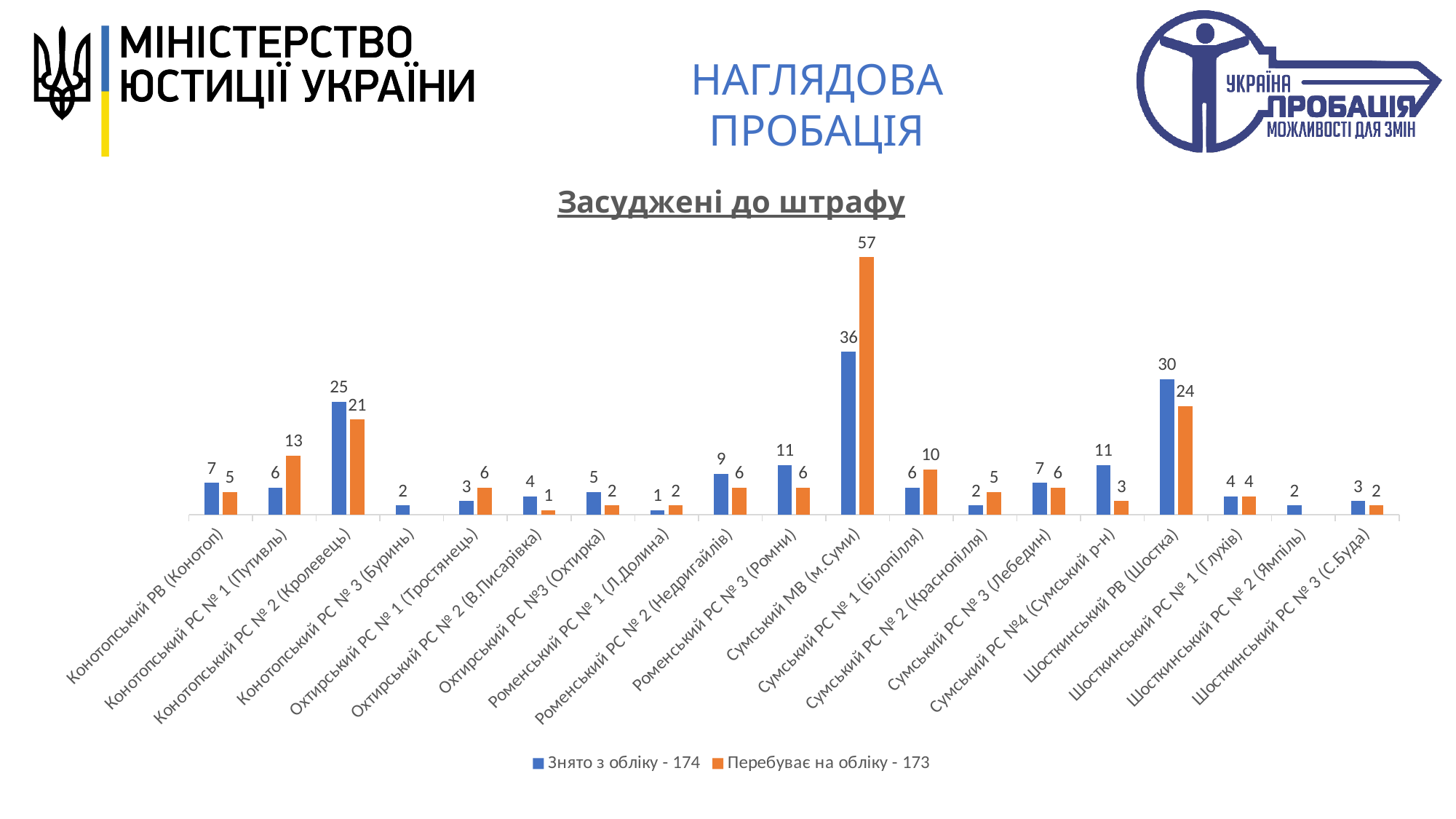
What kind of chart is shown on the slide? Bar chart What is the difference between "Перебуває на обліку" and "Знято з обліку" for Сумський МВ (м.Суми)? 21 For Сумський РС №4 (Сумський р-н), which is larger: "Знято з обліку" or "Перебуває на обліку"? Знято з обліку What is the value of "Перебуває на обліку" for Сумський МВ (м.Суми)? 57 What is the value of "Знято з обліку" for Сумський МВ (м.Суми)? 36 What is the value of "Перебуває на обліку" for Конотопський РС № 1 (Путивль)? 13 Which category has the highest value of "Перебуває на обліку"? Сумський МВ (м.Суми) How many series does the legend list? 2 What is the difference between "Знято з обліку" and "Перебуває на обліку" for Конотопський РС № 2 (Кролевець)? 4 What is the title of the chart? Засуджені до штрафу How many categories are shown on the x axis of the chart? 19 What is the value of "Знято з обліку" for Шосткинський РВ (Шостка)? 30